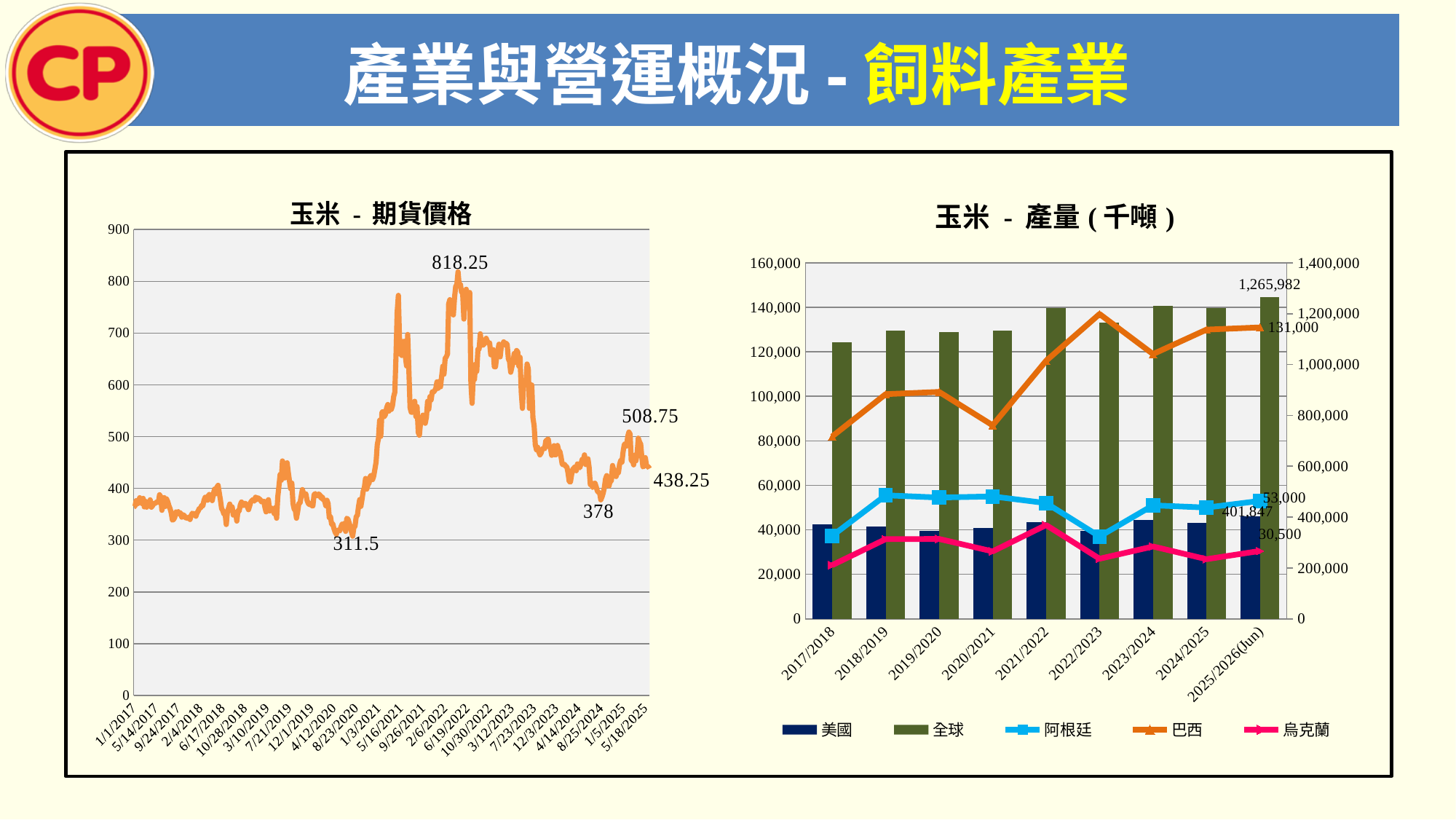
In the 玉米 - 產量 (千噸) chart, is the 巴西 value for 2017/2018 greater or less than 100,000 on the left axis? less In the 玉米 - 期貨價格 chart, what is the difference between the labelled values 508.75 and 438.25? 70.5 In the 玉米 - 期貨價格 chart, what is the highest labelled price? 818.25 In the 玉米 - 產量 (千噸) chart, what is the 全球 value for 2025/2026(Jun)? 1,265,982 In the 玉米 - 產量 (千噸) chart, what is the 阿根廷 value for 2025/2026(Jun)? 53,000 In the 玉米 - 產量 (千噸) chart, what is the 烏克蘭 value for 2025/2026(Jun)? 30,500 In the 玉米 - 產量 (千噸) chart, how many series does the legend list? 5 In the 玉米 - 期貨價格 chart, what is the lowest labelled price? 311.5 In the 玉米 - 期貨價格 chart, what is the difference between the labelled peak 818.25 and the labelled low 311.5? 506.75 In the 玉米 - 期貨價格 chart, what is the last labelled value at the end of the series? 438.25 In the 玉米 - 產量 (千噸) chart, how many crop-year categories are shown on the x axis? 9 In the 玉米 - 產量 (千噸) chart, what is the 巴西 value for 2025/2026(Jun)? 131,000